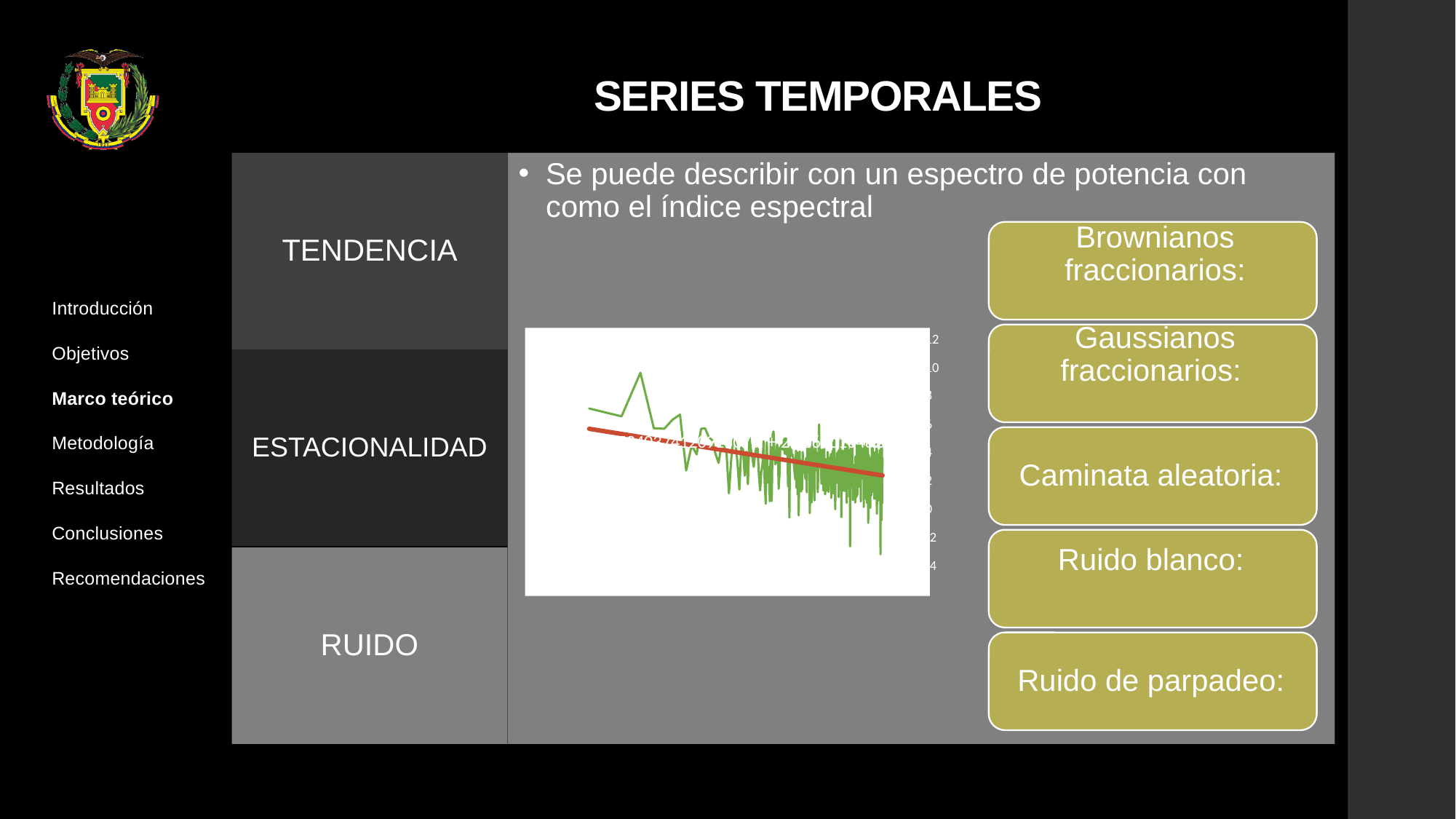
Overall, do the values of the green series in the chart rise or fall from left to right? fall What kind of chart is shown on the slide? line chart Does the red trend line in the chart rise or fall along the x axis? fall What colour is the noisy data series plotted in the chart? green What colour is the straight trend line drawn over the data in the chart? red